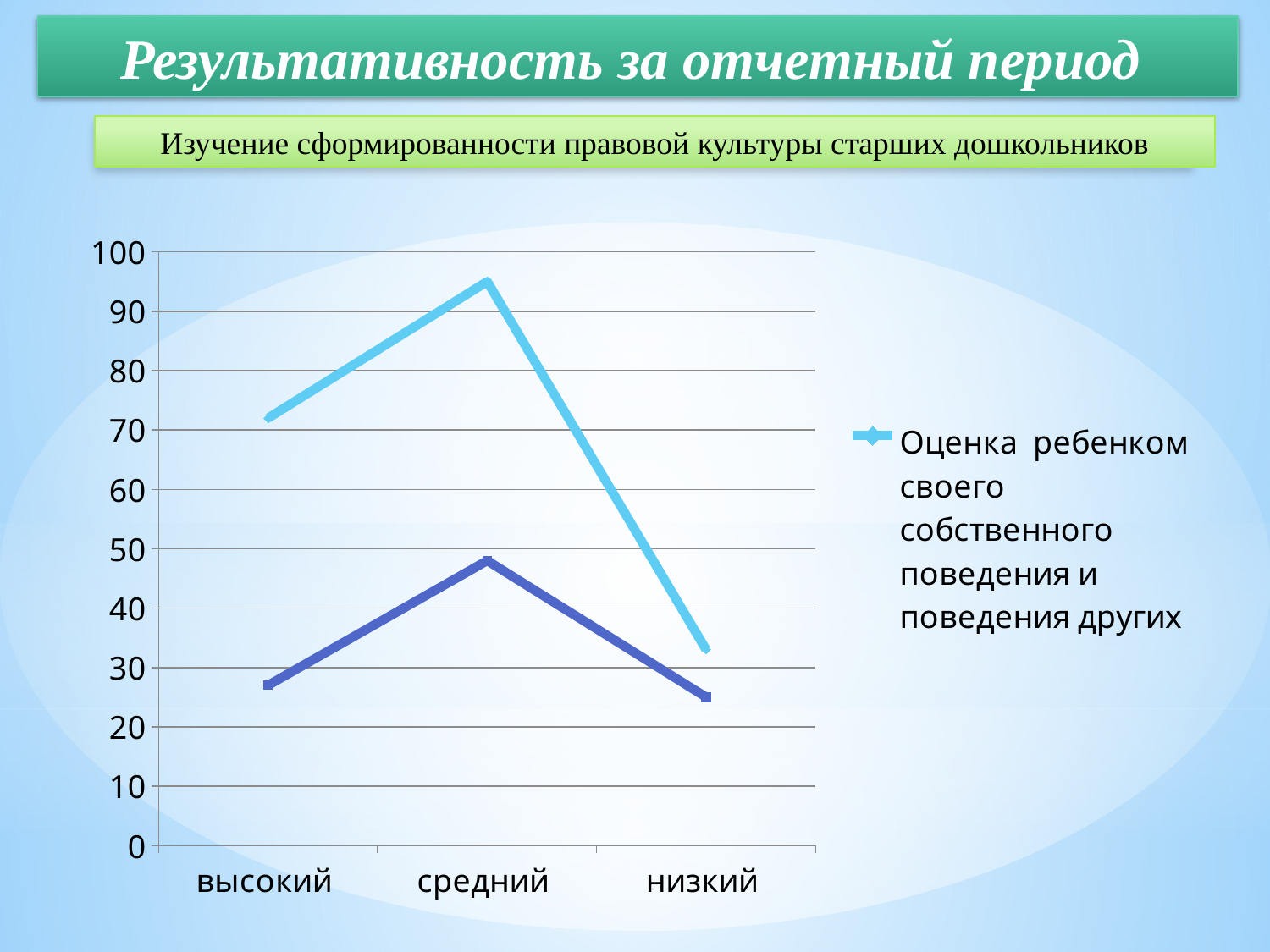
How many categories are shown on the x axis of the chart? 3 What kind of chart is shown on the slide? line chart For the series 'Оценка ребенком своего собственного поведения и поведения других', which category has the lowest value? низкий For the series 'Оценка ребенком своего собственного поведения и поведения других', which category has the highest value? средний For the series 'Оценка ребенком своего собственного поведения и поведения других', which is larger: the value for 'высокий' or the value for 'низкий'? высокий Is the value of the series 'Оценка ребенком своего собственного поведения и поведения других' for 'средний' greater or less than 90? greater Is the value of the dark blue line for 'низкий' greater or less than 30? less For the category 'средний', which line has the larger value: the light blue line or the dark blue line? the light blue line Is the value of the series 'Оценка ребенком своего собственного поведения и поведения других' for 'высокий' greater or less than 60? greater How many series does the chart's legend list? 1